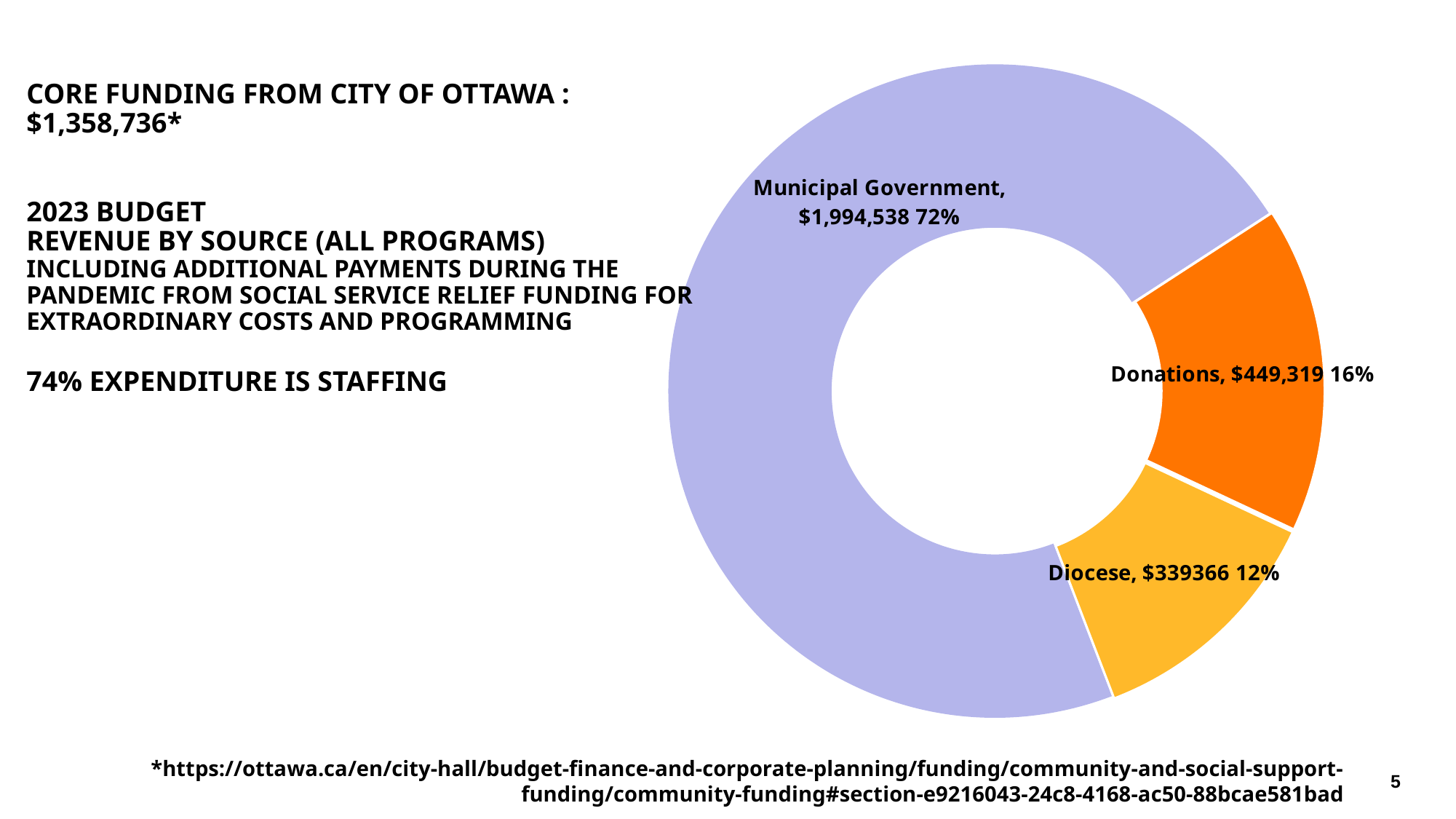
What is the difference between the Donations value and the Diocese value? $109,953 What is the value for Donations in the chart? $449,319 How many revenue sources are shown in the chart? 3 What colour is the Municipal Government slice in the chart? light purple What is the value for Diocese in the chart? $339366 Which revenue source has the smallest share in the chart? Diocese Which revenue source has the largest share in the chart? Municipal Government What percentage share of revenue does Donations represent? 16% What percentage share of revenue does Municipal Government represent? 72% What kind of chart is shown on the slide? doughnut chart Which is larger, the value for Donations or the value for Diocese? Donations What is the value for Municipal Government in the chart? $1,994,538